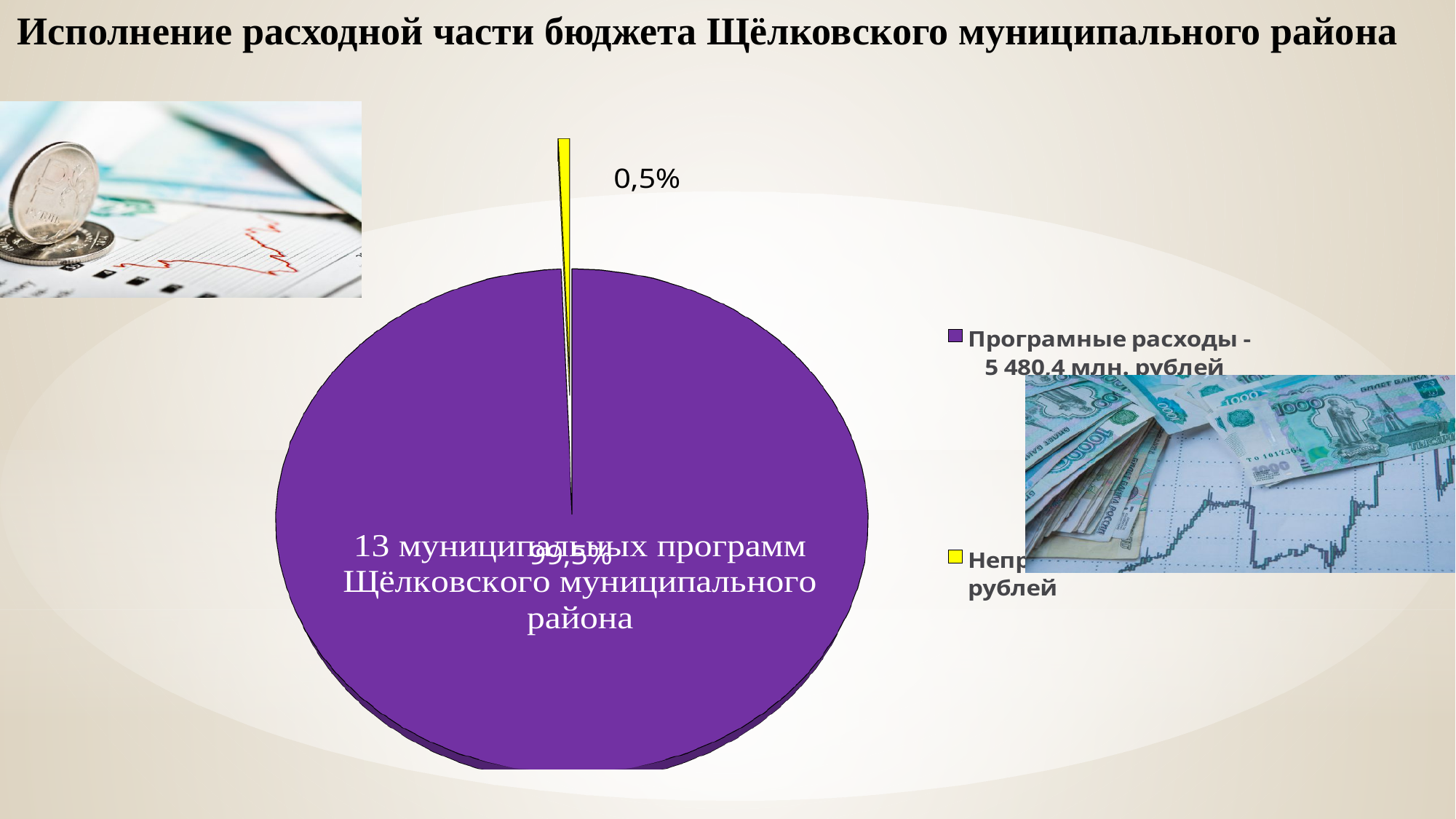
What kind of chart is shown on the slide? Pie chart What is the difference in percentage points between the purple slice (99,5%) and the yellow slice (0,5%)? 99 What amount in million rubles does the legend give for "Програмные расходы"? 5 480,4 млн. рублей What percentage does the smallest slice of the pie chart represent? 0,5% What do the two slice percentages of the pie chart add up to? 100% Which slice of the pie chart is the largest? Програмные расходы What share of the pie does "Програмные расходы" represent? 99,5% What colour is the slice for "Програмные расходы"? Purple What percentage is shown for the yellow slice of the pie chart? 0,5% How many slices does the pie chart have? 2 Which slice is larger, the purple one or the yellow one? The purple one (Програмные расходы) How many entries does the legend of the pie chart list? 2